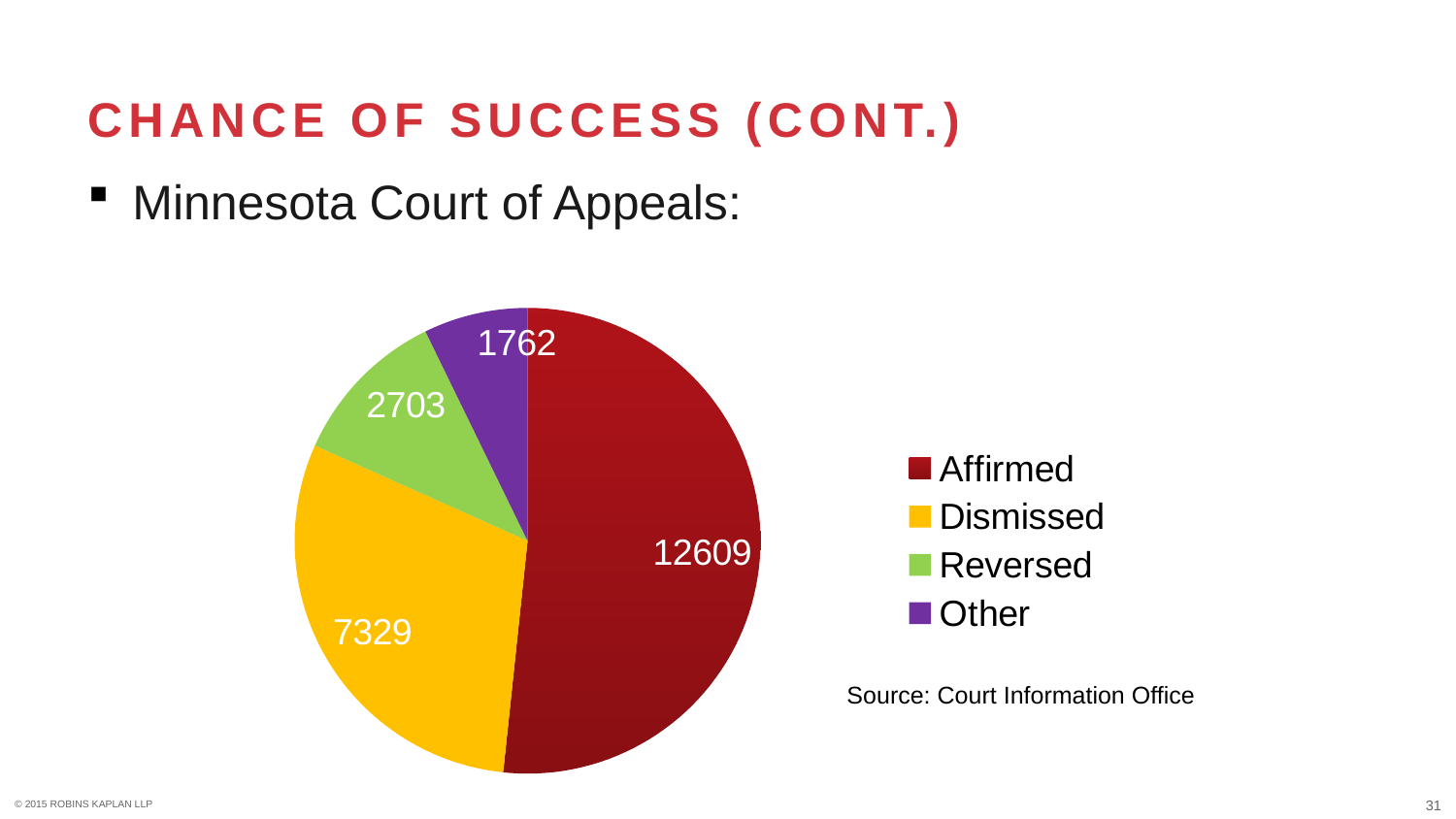
What is the value for Dismissed in the pie chart? 7329 Which category has the smallest slice of the pie chart? Other Which is larger, Reversed or Other? Reversed What is the difference between the Affirmed and Dismissed values? 5280 What is the total of all four slices in the pie chart? 24403 What is the value for Affirmed in the pie chart? 12609 What is the value for Other in the pie chart? 1762 What type of chart is shown on the slide? Pie chart Which category has the largest slice of the pie chart? Affirmed How many categories does the pie chart show? 4 What is the value for Reversed in the pie chart? 2703 Which colour represents Dismissed in the pie chart? Yellow